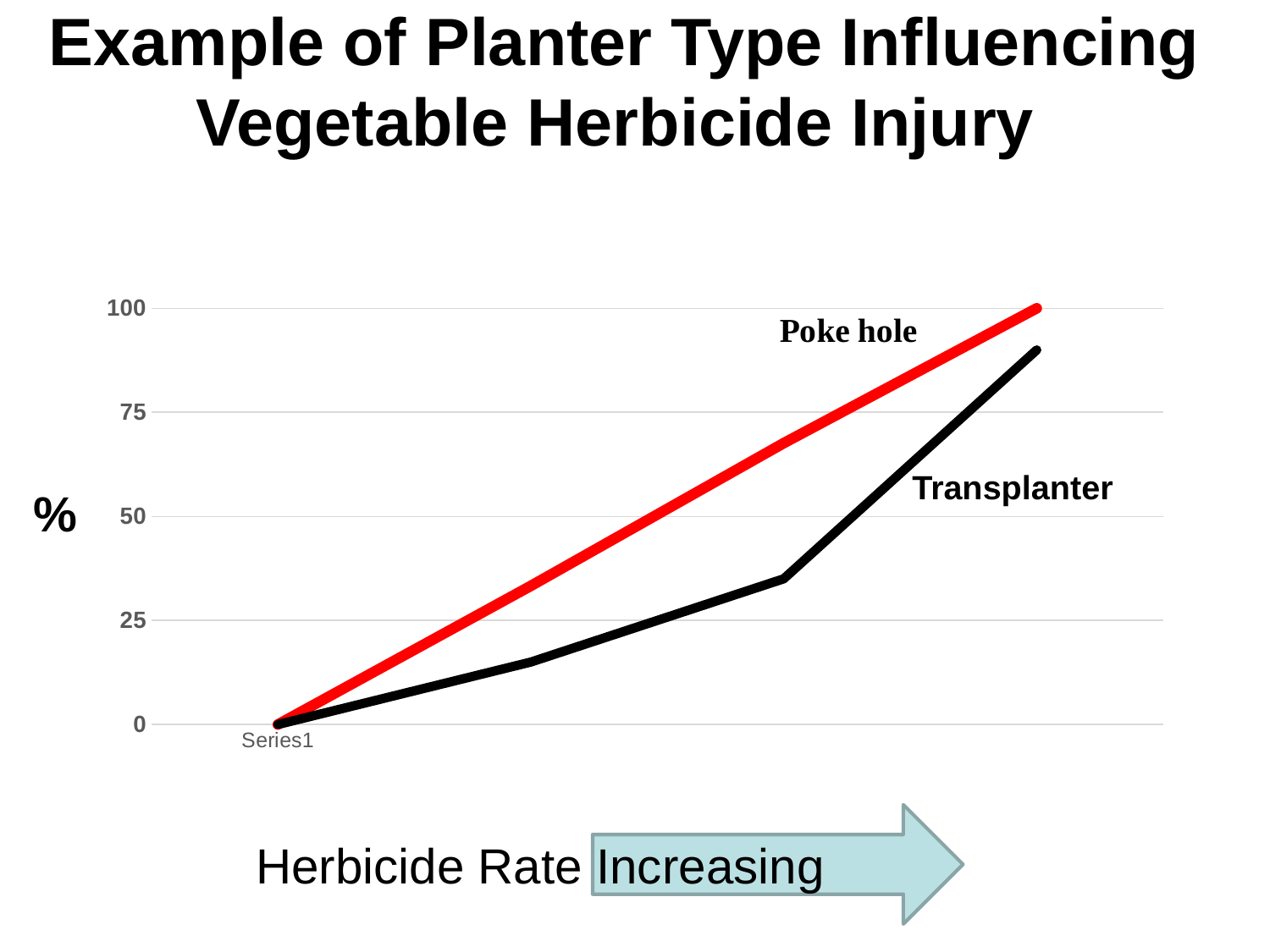
How many lines (series) are plotted on the chart? 2 Do the values for Transplanter rise or fall as herbicide rate increases along the x axis? rise What are the names of the two series plotted on the chart? Poke hole and Transplanter What kind of chart is shown on the slide? line chart At the highest herbicide rate (right end of the chart), which series has the larger value, Poke hole or Transplanter? Poke hole Do the values for Poke hole rise or fall along the x axis? rise Is the value of the Transplanter line at its third point (the bend near the middle-right) greater or less than 50? less What value do both lines start at on the left of the chart? 0 What colour is the Poke hole line? red Which series reaches the highest value on the chart? Poke hole Is the final value for Transplanter at the right end of the chart greater or less than 75? greater What is the highest value reached by the Poke hole line? 100